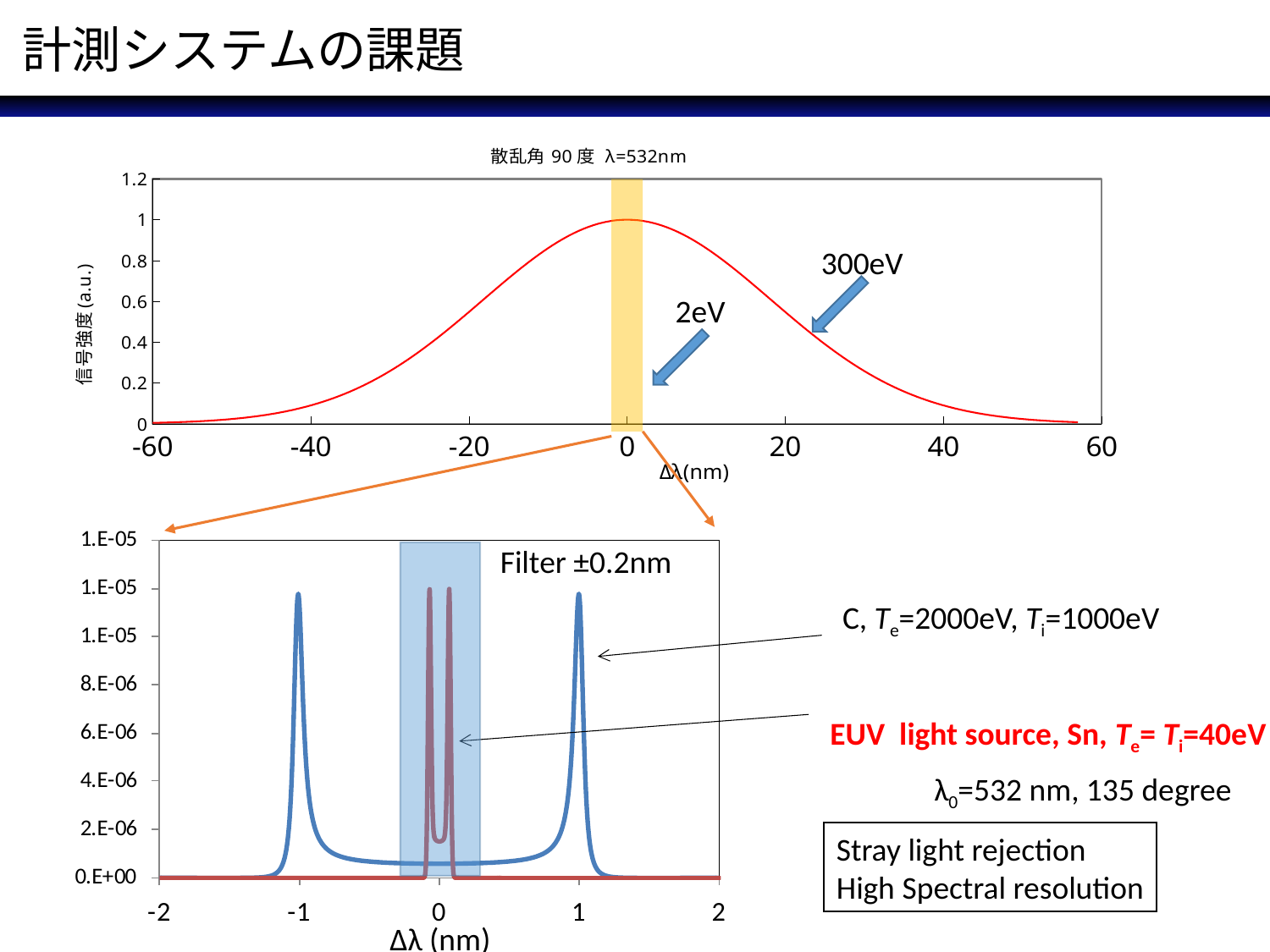
In the bottom chart, is the blue curve's value at Δλ = 0 greater or less than 2.E-06? less What is the y-axis label of the top chart? 信号強度 (a.u.) In the bottom chart, is the blue curve's value at Δλ = 1 greater or less than 8.E-06? greater In the top chart, how many tick labels are shown on the Δλ(nm) axis? 7 In the top chart, is the value of the red curve at Δλ = 40 greater or less than 0.2? less In the top chart, does the red curve rise or fall as Δλ goes from 0 to 60? fall How many data series are plotted in the bottom chart? 2 What type of chart is the top chart titled 散乱角 90 度 λ=532nm? line chart In the top chart, at which Δλ value does the red curve reach its maximum? 0 In the bottom chart, at which two Δλ values does the blue curve have its peaks? -1 and 1